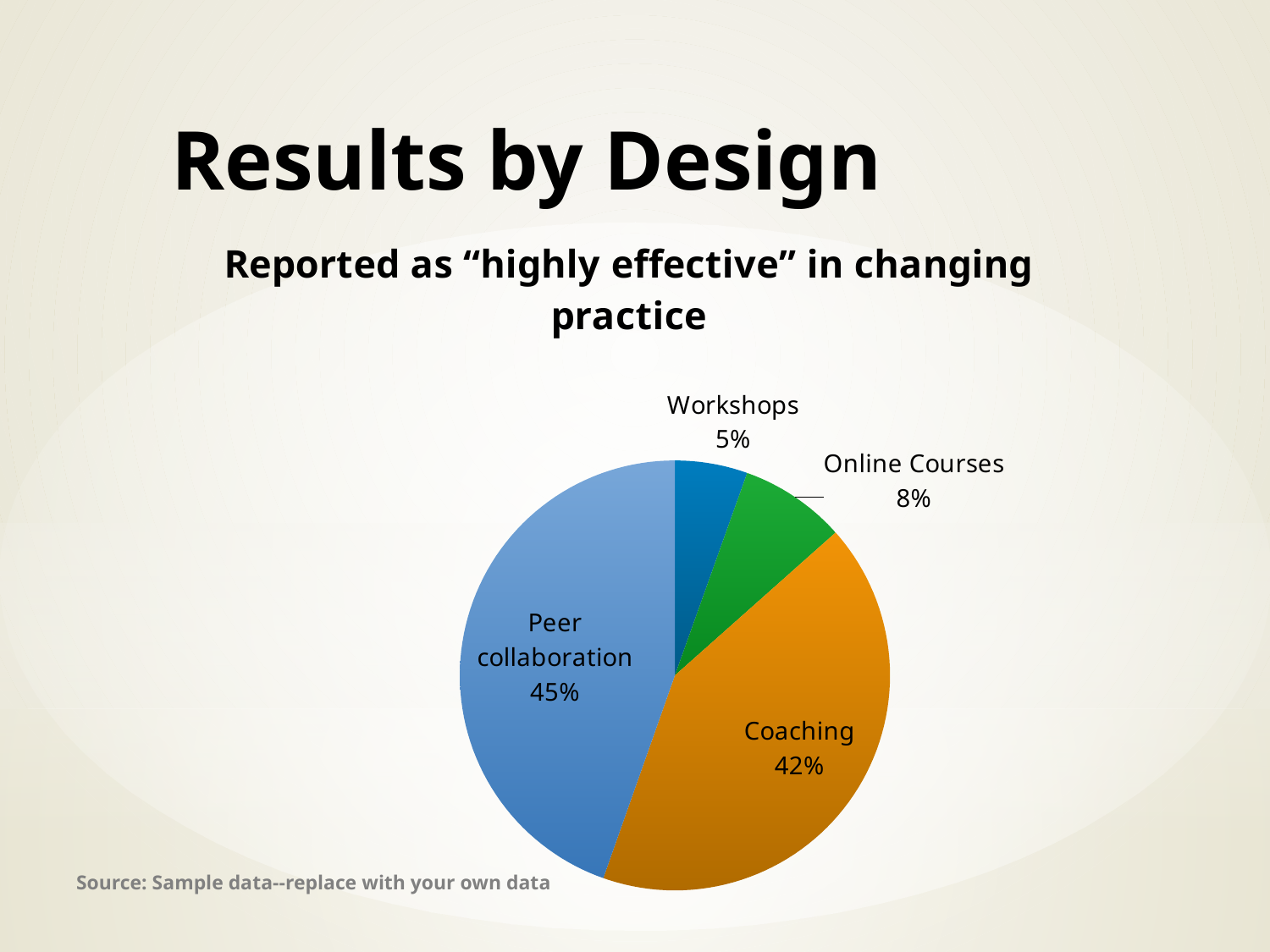
What is the difference between the Online Courses and Workshops values? 3% What is the title of the chart? Reported as "highly effective" in changing practice What is the value shown for Workshops? 5% What is the value shown for Online Courses? 8% Which is larger, Online Courses or Workshops? Online Courses What is the difference between the Peer collaboration and Coaching values? 3% Which category has the largest slice of the pie? Peer collaboration How many categories are shown in the pie chart? 4 What is the value shown for Coaching? 42% Which category has the smallest slice of the pie? Workshops What kind of chart is shown on the slide? pie chart What share of the pie does Peer collaboration have? 45%